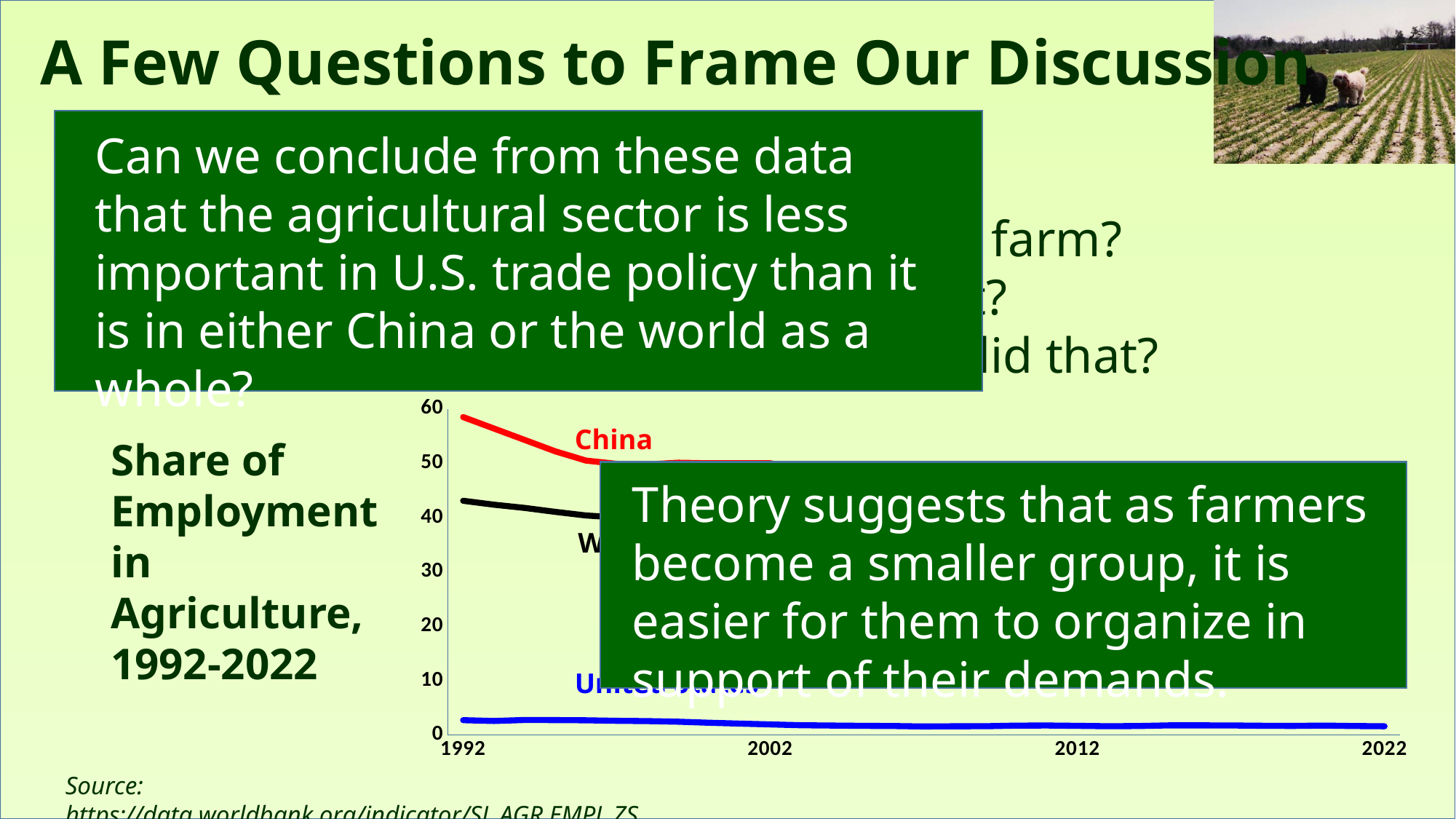
In 1992, which is larger: the value for China or the value for the United States? China Is the value for China in 1992 greater or less than 50? greater Is the value for the United States in 2022 greater or less than 10? less How many lines are plotted on the chart? 3 Which series has the highest value in 1992? China What is the last year shown on the x axis? 2022 What colour is the China line? red What is the title of the chart? Share of Employment in Agriculture, 1992-2022 What kind of chart is shown on the slide? line chart Is the value for the United States in 1992 greater or less than 10? less Does the China line rise or fall between 1992 and 2002? fall Which series has the lowest value in 1992? United States